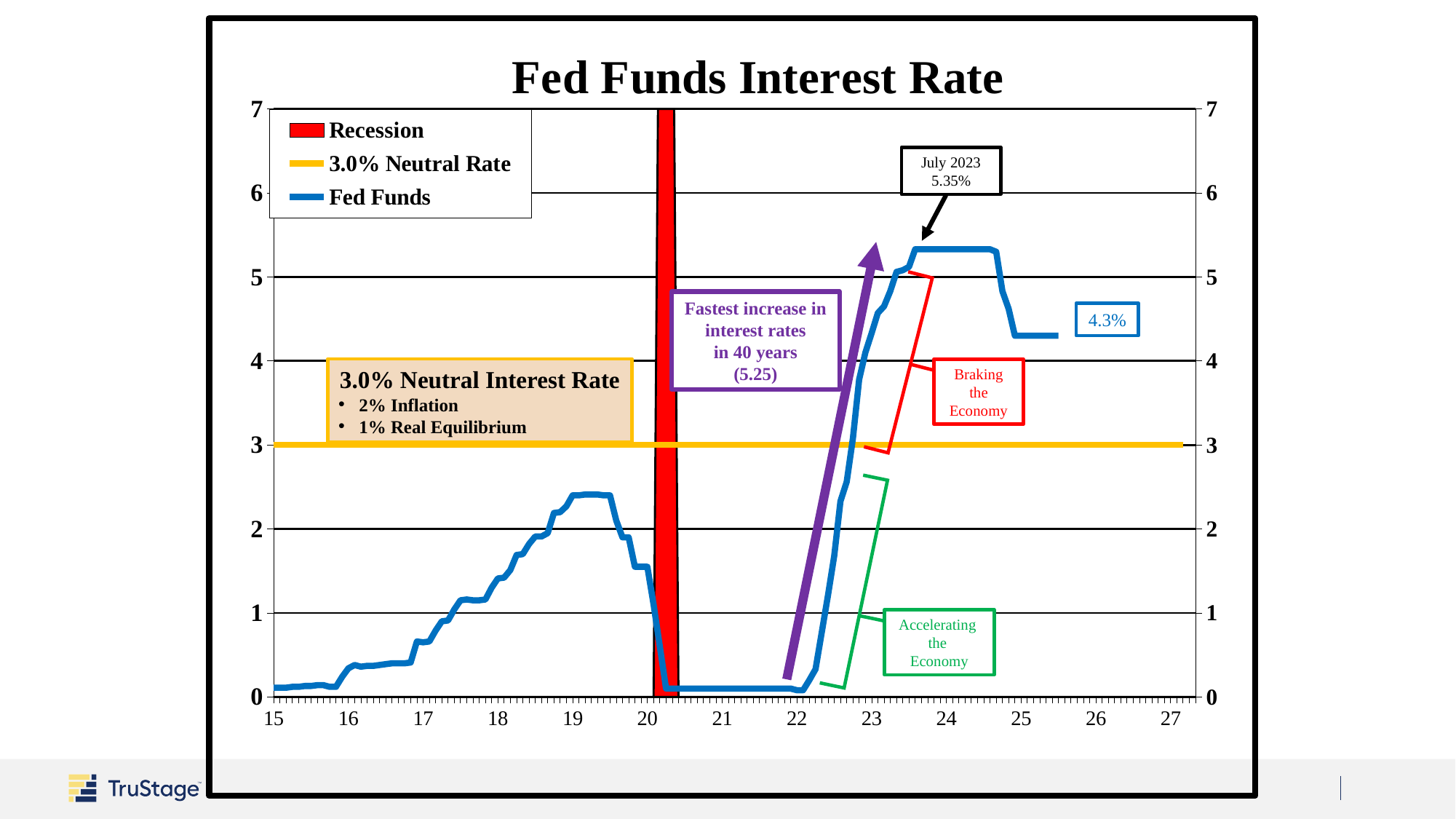
What kind of chart is shown on the slide? Line chart Is the Fed Funds rate at year 21 greater or less than 1? less What is the title of the chart? Fed Funds Interest Rate What is the neutral interest rate shown by the yellow horizontal line? 3.0% Does the Fed Funds line rise or fall between year 22 and year 23? rise Is the Fed Funds rate at year 24 greater or less than 5? greater Is the Fed Funds rate at year 19 greater or less than 2? greater What value is labeled at the right end of the Fed Funds line? 4.3% Which is larger, the July 2023 rate or the 4.3% rate labeled at the end of the line? July 2023 (5.35%) What is the difference between the July 2023 rate of 5.35% and the later labeled rate of 4.3%? 1.05 percentage points What Fed Funds rate is labeled for July 2023? 5.35% How many entries does the chart's legend list? 3